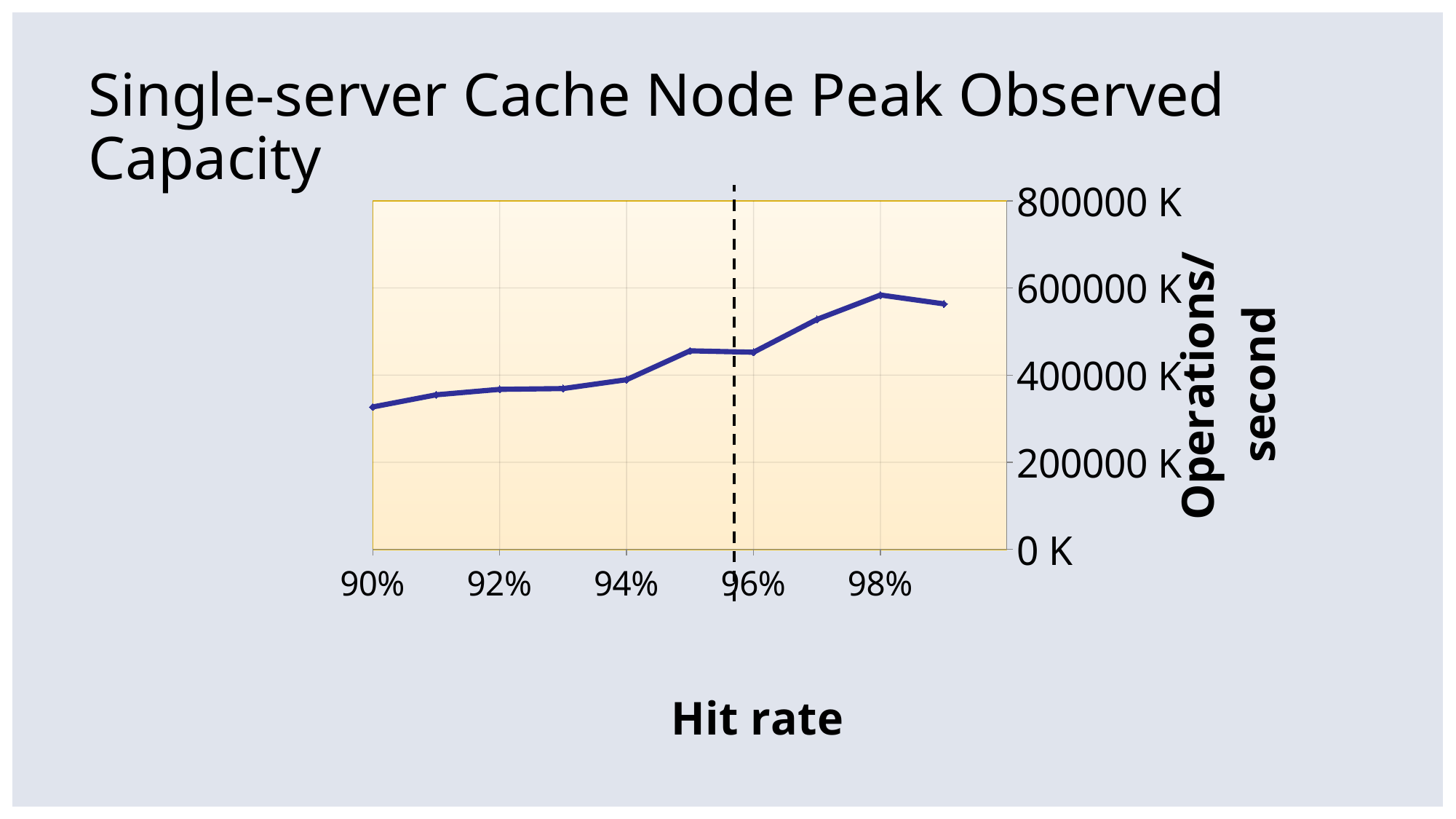
What kind of chart is shown on the slide? line chart Do the operations/second values generally rise or fall as the hit rate increases from 90% to 98%? rise Is the value at a 98% hit rate greater or less than 400000 K? greater What is the title of the chart? Single-server Cache Node Peak Observed Capacity At which hit rate is the operations/second value lowest? 90% At which hit rate is the operations/second value highest? 98% Which has the larger operations/second value, a 92% hit rate or a 97% hit rate? 97% Is the value at a 90% hit rate greater or less than 400000 K? less What is the label of the x axis? Hit rate How many data points are plotted on the line? 10 Is the value at a 97% hit rate greater or less than 400000 K? greater